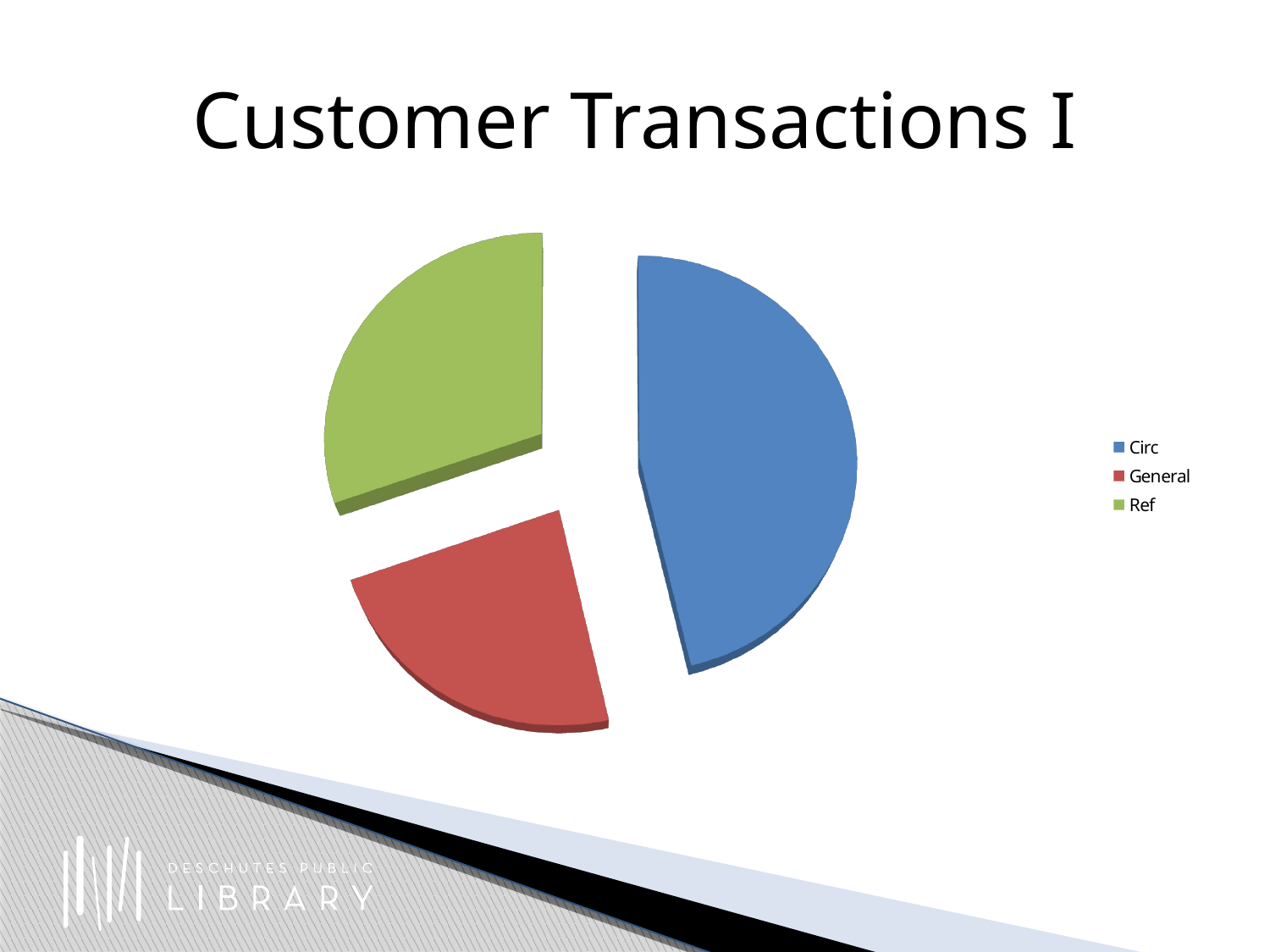
How many entries does the legend list? 3 What kind of chart is shown on the slide? pie chart Which colour represents the General category in the pie chart? red What is the title of the slide containing the pie chart? Customer Transactions I Which slice is larger, Ref or Circ? Circ Which category has the largest slice of the pie? Circ Which slice is larger, Circ or General? Circ How many slices does the pie chart have? 3